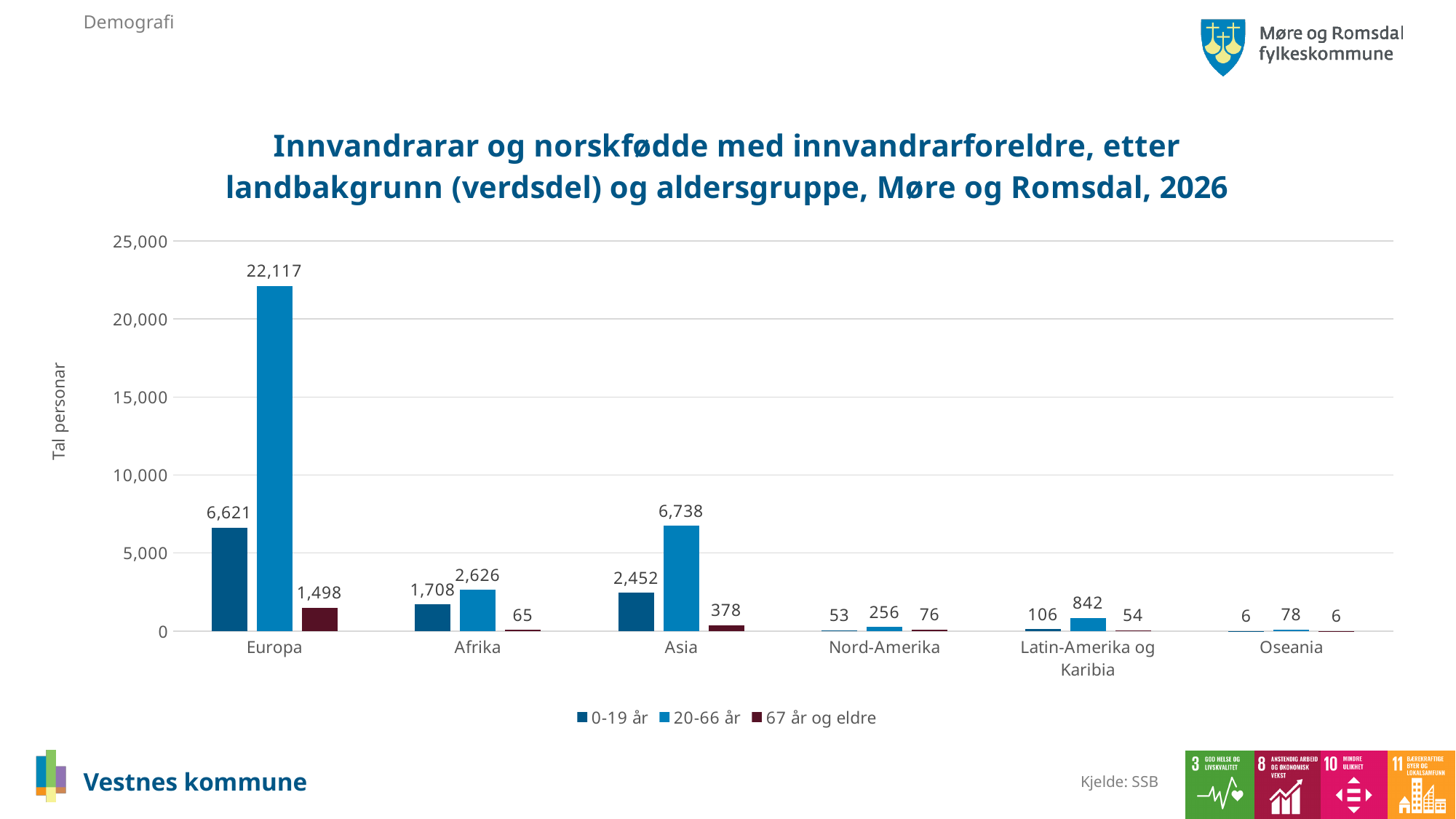
How many series does the legend list? 3 What is the label of the y axis? Tal personar Which is larger: the 0-19 år value for Asia or the 0-19 år value for Afrika? Asia What is the value for the 20-66 år series for Europa? 22,117 Is the 0-19 år value for Europa greater or less than 5,000? greater What is the difference between the 20-66 år and 0-19 år values for Afrika? 918 Which region has the lowest value for the 0-19 år series? Oseania How many regions are shown on the x axis? 6 Which region has the highest value for the 20-66 år series? Europa What is the value for the 67 år og eldre series for Asia? 378 What is the value for the 0-19 år series for Latin-Amerika og Karibia? 106 What kind of chart is shown on the slide? bar chart